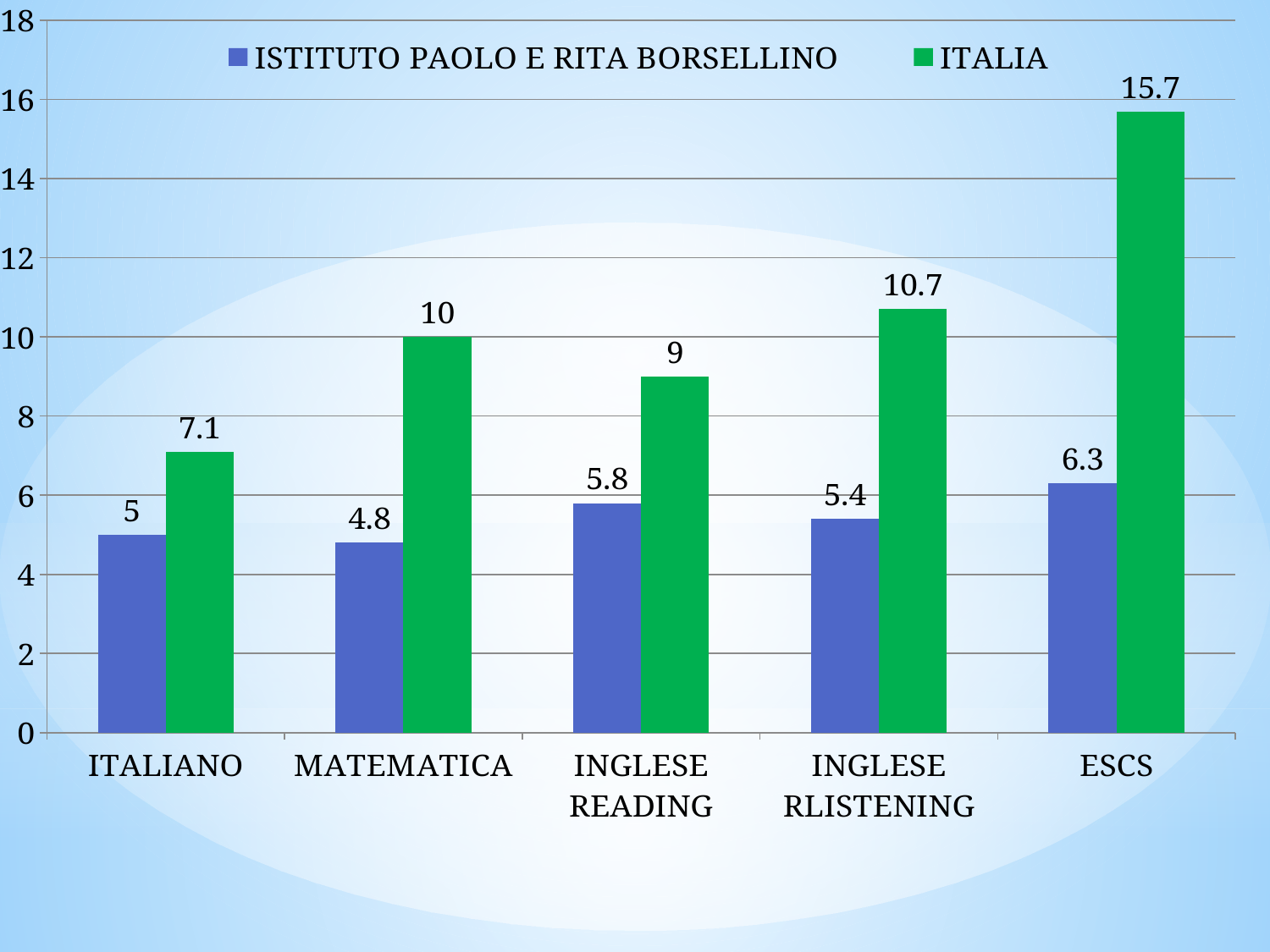
How many categories are shown on the x axis? 5 How many series does the legend list? 2 What is the value for ITALIA in INGLESE RLISTENING? 10.7 What is the difference between the ITALIA and ISTITUTO PAOLO E RITA BORSELLINO values in INGLESE READING? 3.2 What is the value for ITALIA in ESCS? 15.7 Which category has the highest value for ITALIA? ESCS What is the difference between the ITALIA and ISTITUTO PAOLO E RITA BORSELLINO values in ESCS? 9.4 Which category has the lowest value for ISTITUTO PAOLO E RITA BORSELLINO? MATEMATICA What is the value for ISTITUTO PAOLO E RITA BORSELLINO in ITALIANO? 5 What kind of chart is shown on the slide? Bar chart Which colour represents the ITALIA series? Green Which is larger in MATEMATICA: the ITALIA value or the ISTITUTO PAOLO E RITA BORSELLINO value? ITALIA